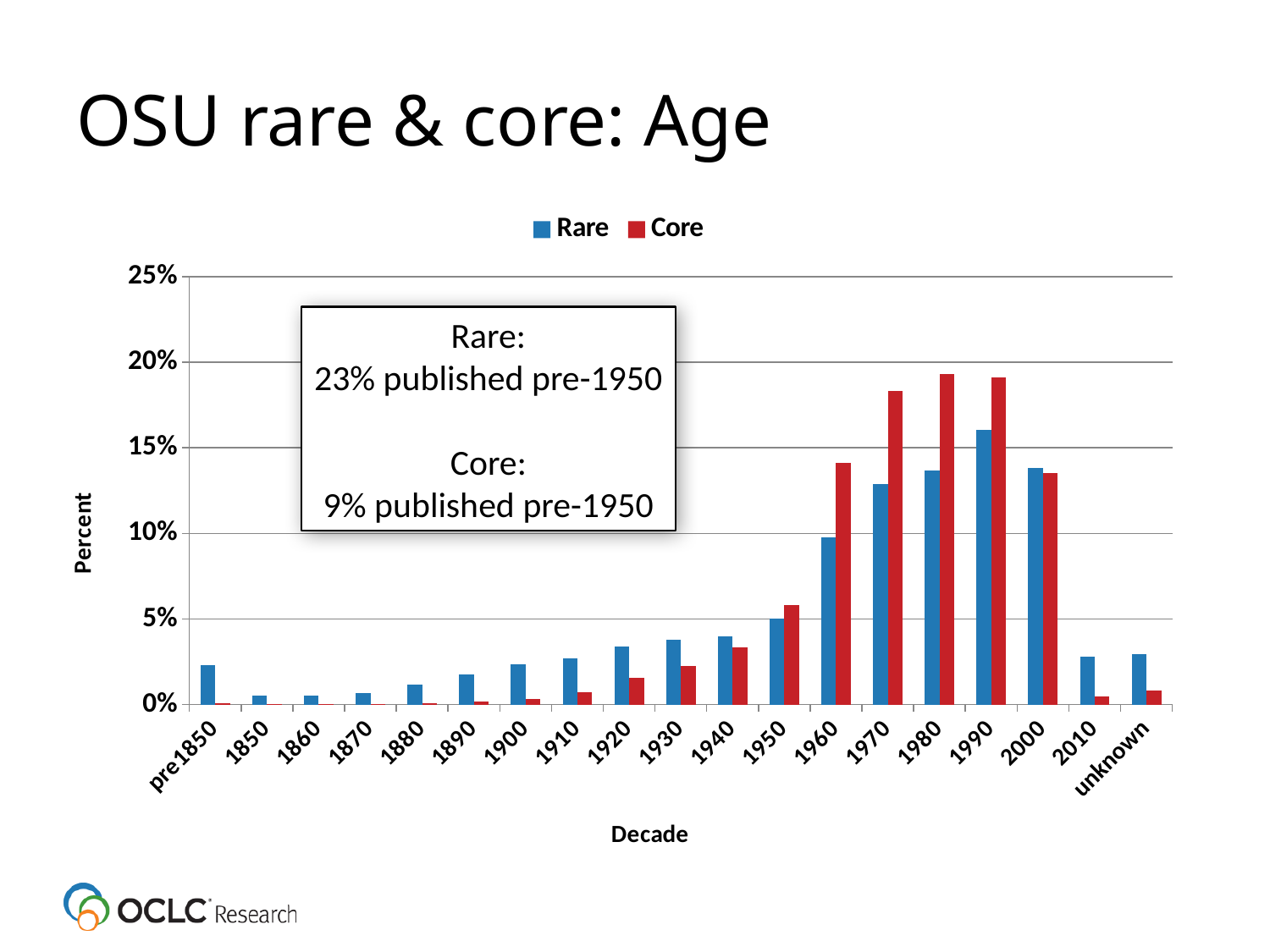
Is the Core value for 2010 greater or less than 5%? less How many series does the legend list? 2 Which decade has the highest value for the Rare series? 1990 Is the Rare value for 1990 greater or less than 15%? greater How many decade categories are shown on the x axis? 19 According to the text box on the chart, what percentage of Core was published pre-1950? 9% What kind of chart is shown on the slide? bar chart For 1970, which series has the larger value, Rare or Core? Core For pre1850, which series has the larger value, Rare or Core? Rare Is the Core value for 1970 greater or less than 15%? greater What is the title of the slide? OSU rare & core: Age